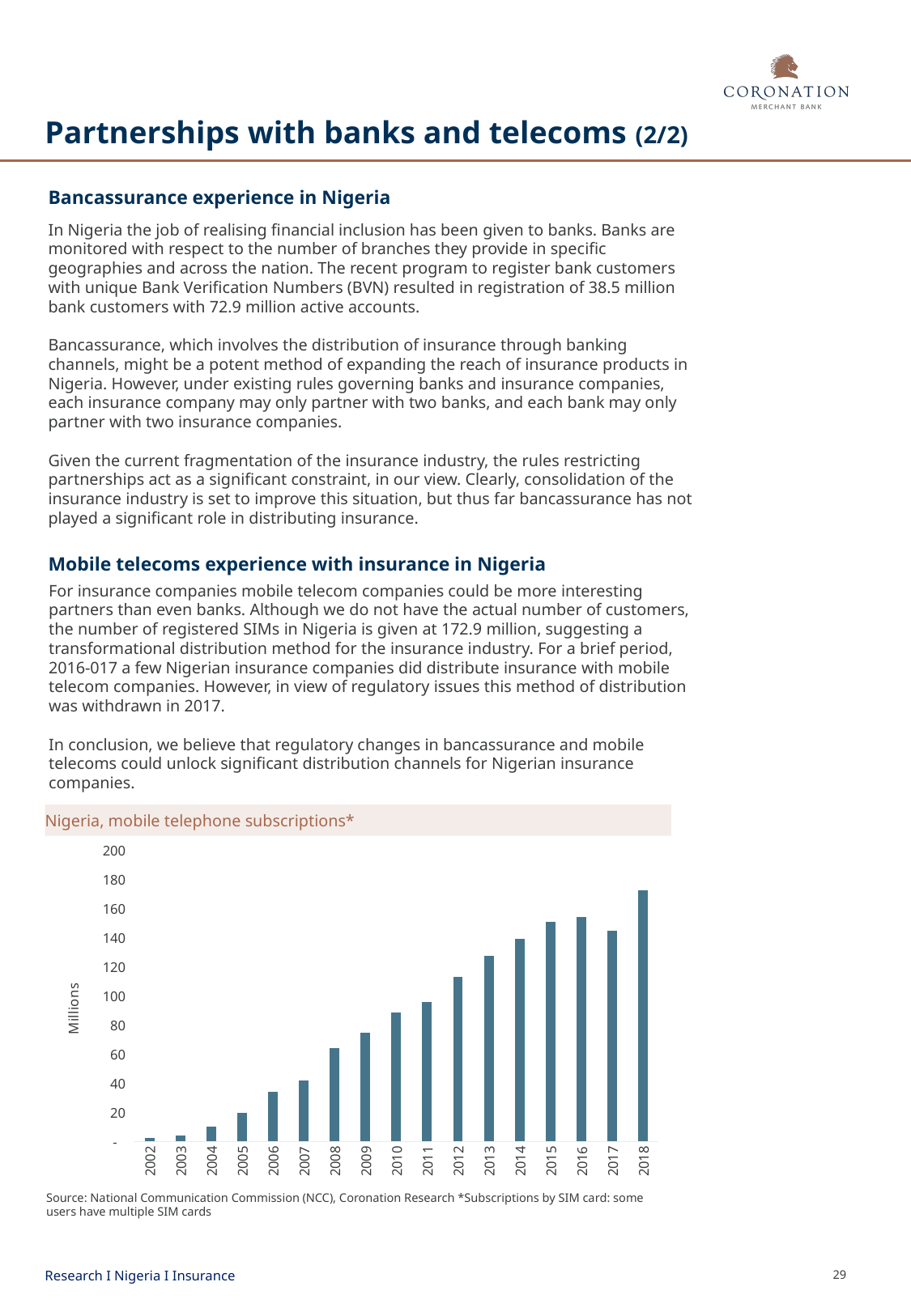
In the mobile telephone subscriptions chart, which year has the larger value, 2016 or 2017? 2016 Is the value for 2018 in the mobile telephone subscriptions chart greater or less than 160? greater Do mobile telephone subscriptions in Nigeria generally rise or fall from 2002 to 2018 in the chart? Rise Is the value for 2014 in the mobile telephone subscriptions chart greater or less than 120? greater Is the value for 2005 in the mobile telephone subscriptions chart greater or less than 40? less What kind of chart is shown under the title "Nigeria, mobile telephone subscriptions*"? Bar chart What unit is shown on the vertical axis of the mobile telephone subscriptions chart? Millions How many years are plotted in the Nigeria mobile telephone subscriptions chart? 17 Which year has the highest number of mobile telephone subscriptions in the chart? 2018 Which year has the lowest number of mobile telephone subscriptions in the chart? 2002